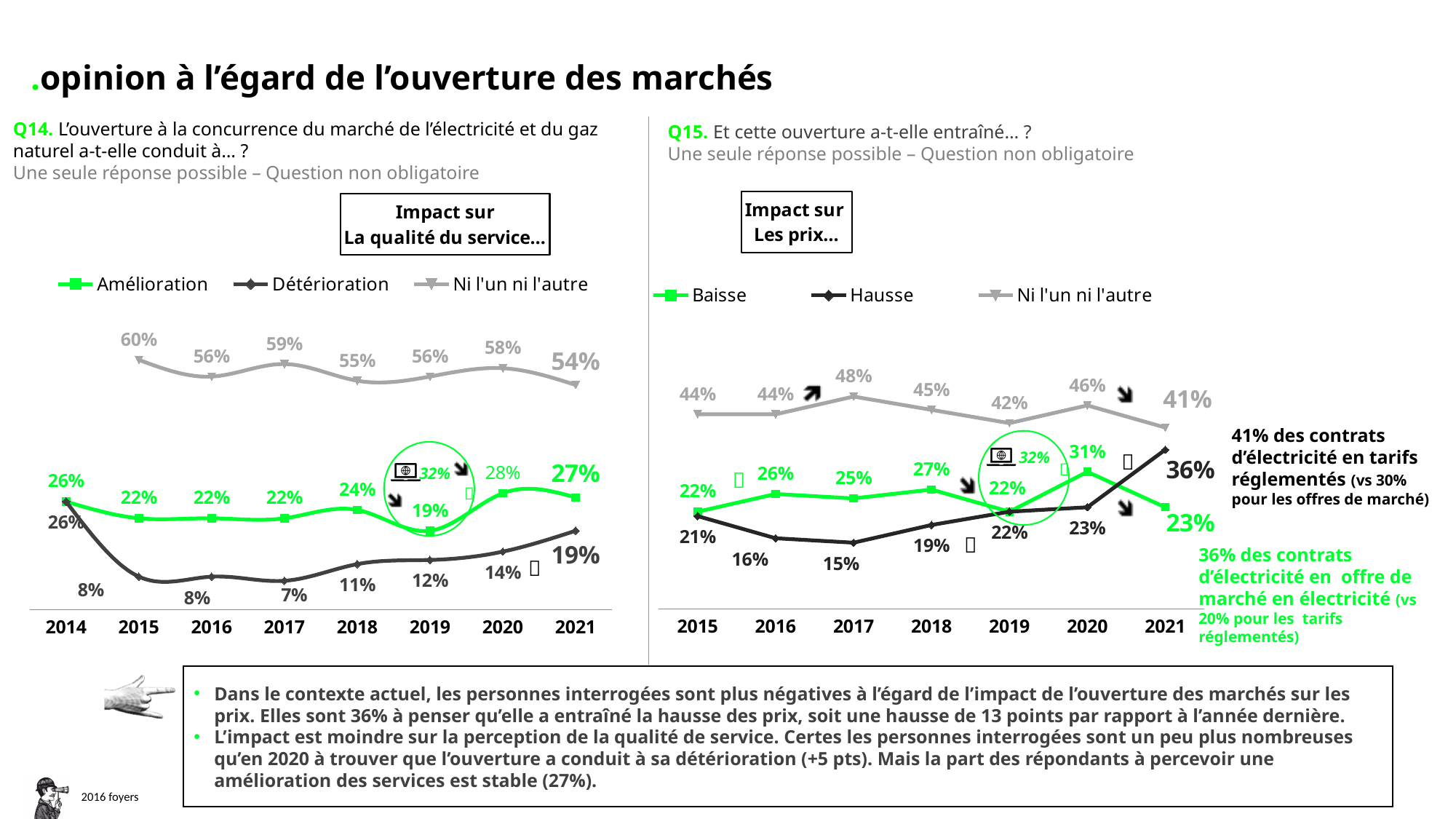
On the 'Impact sur La qualité du service' chart, what is the value for Amélioration in 2021? 27% On the 'Impact sur La qualité du service' chart, how many series does the legend list? 3 On the 'Impact sur Les prix' chart, which is larger in 2021, Baisse or Hausse? Hausse On the 'Impact sur La qualité du service' chart, what is the value for Détérioration in 2017? 7% On the 'Impact sur La qualité du service' chart, in which year is the Ni l'un ni l'autre series highest? 2015 On the 'Impact sur Les prix' chart, how many years are shown on the x axis? 7 On the 'Impact sur Les prix' chart, what is the difference between Hausse in 2021 and Hausse in 2020? 13 points On the 'Impact sur Les prix' chart, what is the value for Hausse in 2021? 36% On the 'Impact sur Les prix' chart, what is the value for Baisse in 2020? 31% What type of chart is used for 'Impact sur Les prix'? Line chart On the 'Impact sur La qualité du service' chart, what is the difference between Amélioration and Détérioration in 2021? 8 points On the 'Impact sur Les prix' chart, in which year is the Hausse series lowest? 2017